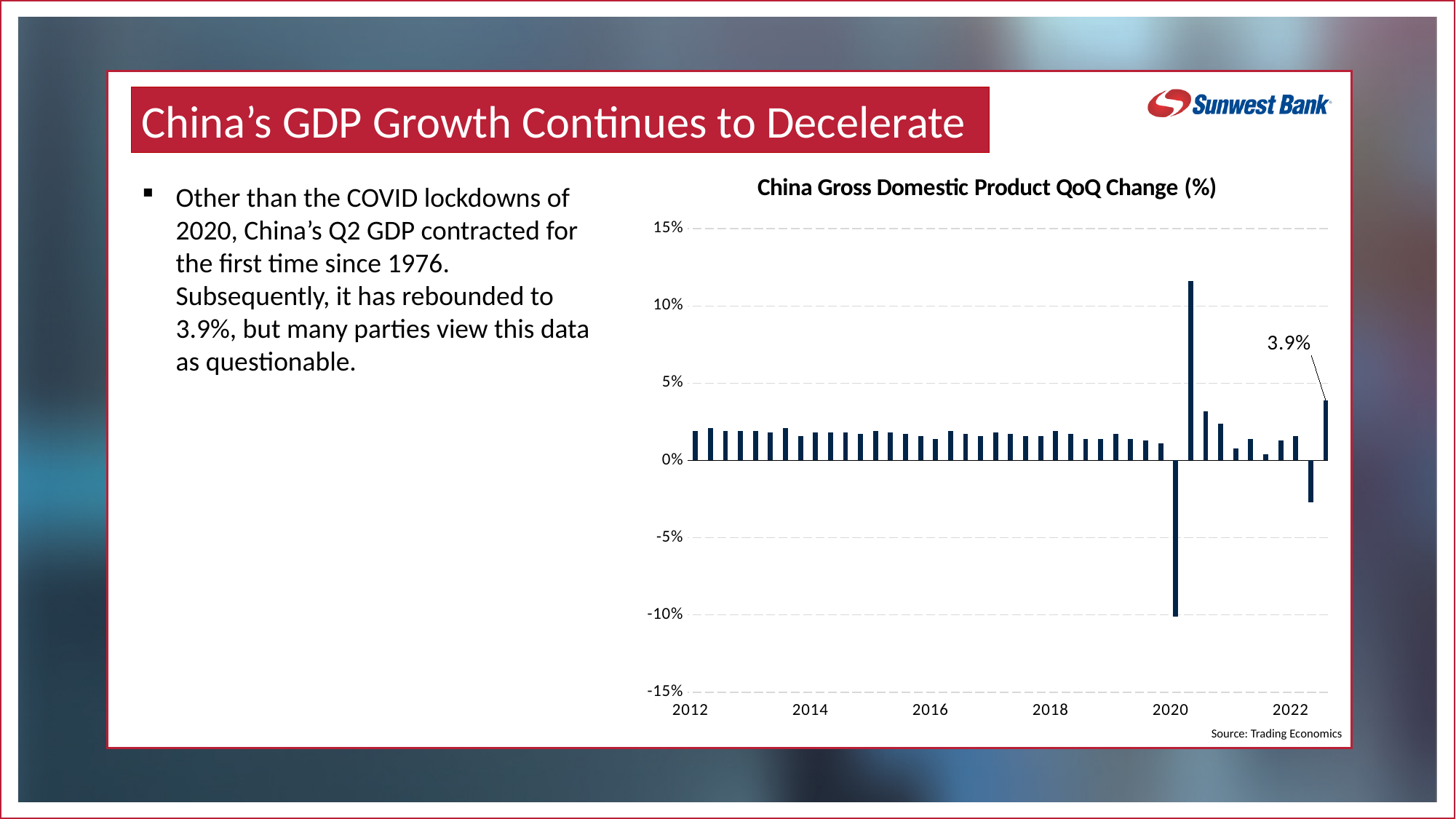
In which year on the x axis does the lowest bar appear? 2020 How many bars in the chart fall below 0%? 2 What kind of chart is shown on the slide? bar chart Which is larger: the tallest bar in 2020 or the bar labeled 3.9%? the tallest bar in 2020 What value is labeled on the last bar of the chart? 3.9% Is the value of the tallest bar in the chart greater or less than 10%? greater What is the title of the chart? China Gross Domestic Product QoQ Change (%) Is the value of the lowest bar in the chart greater or less than -5%? less Is the value of the bar labeled 3.9% greater or less than 5%? less What source is cited for the chart? Trading Economics How many year labels are shown on the x axis? 6 In which year on the x axis does the tallest bar appear? 2020